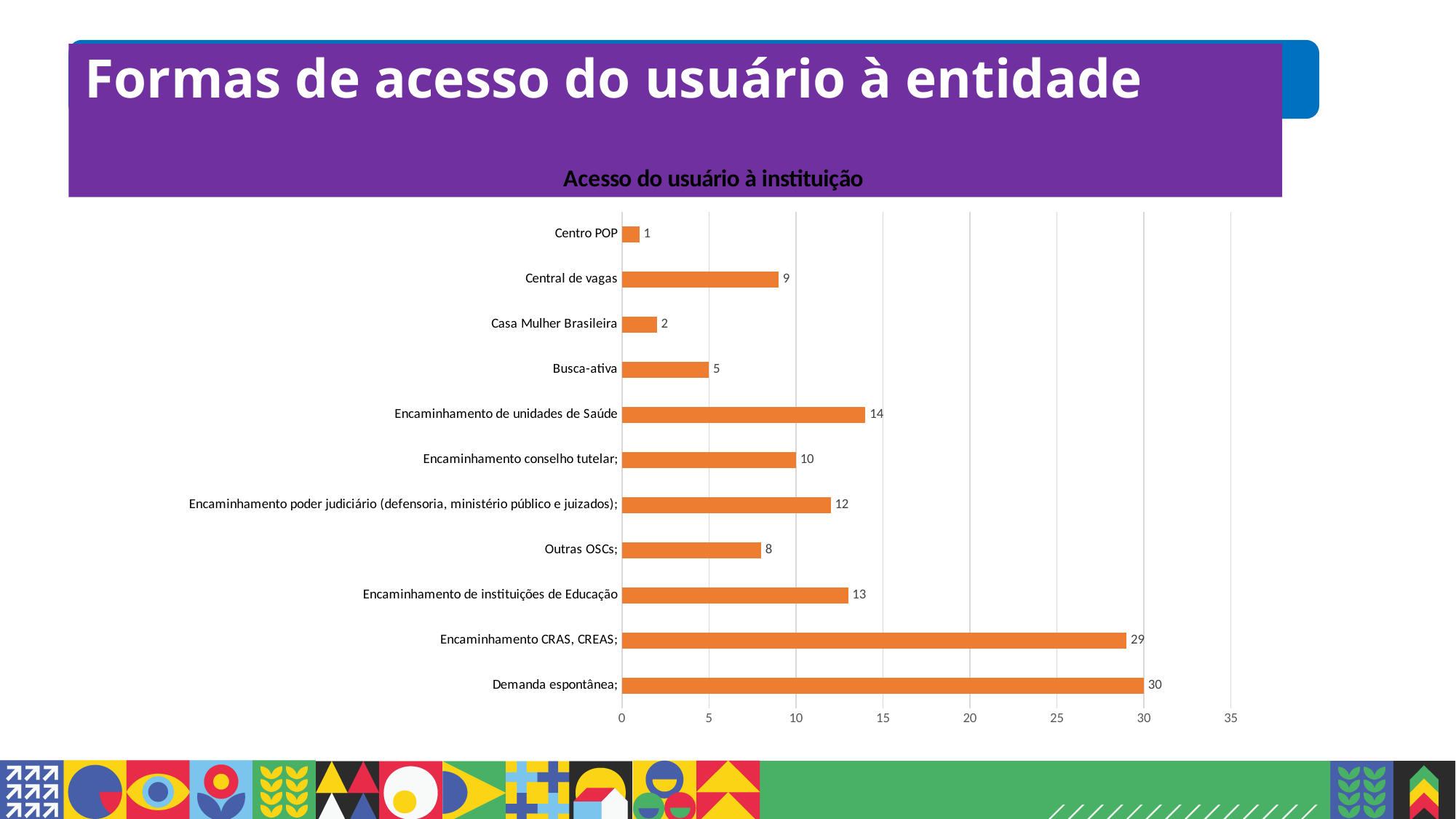
Which is larger, Busca-ativa or Casa Mulher Brasileira? Busca-ativa Which category has the highest value? Demanda espontânea What kind of chart is shown? bar chart What is the difference between Encaminhamento de instituições de Educação and Outras OSCs? 5 What is the value for Demanda espontânea? 30 What is the difference between Demanda espontânea and Encaminhamento CRAS, CREAS? 1 How many categories are shown in the chart? 11 Which category has the lowest value? Centro POP Is the value for Encaminhamento CRAS, CREAS greater or less than 25? greater What is the value for Encaminhamento de unidades de Saúde? 14 What is the value for Central de vagas? 9 What is the title of the chart? Acesso do usuário à instituição